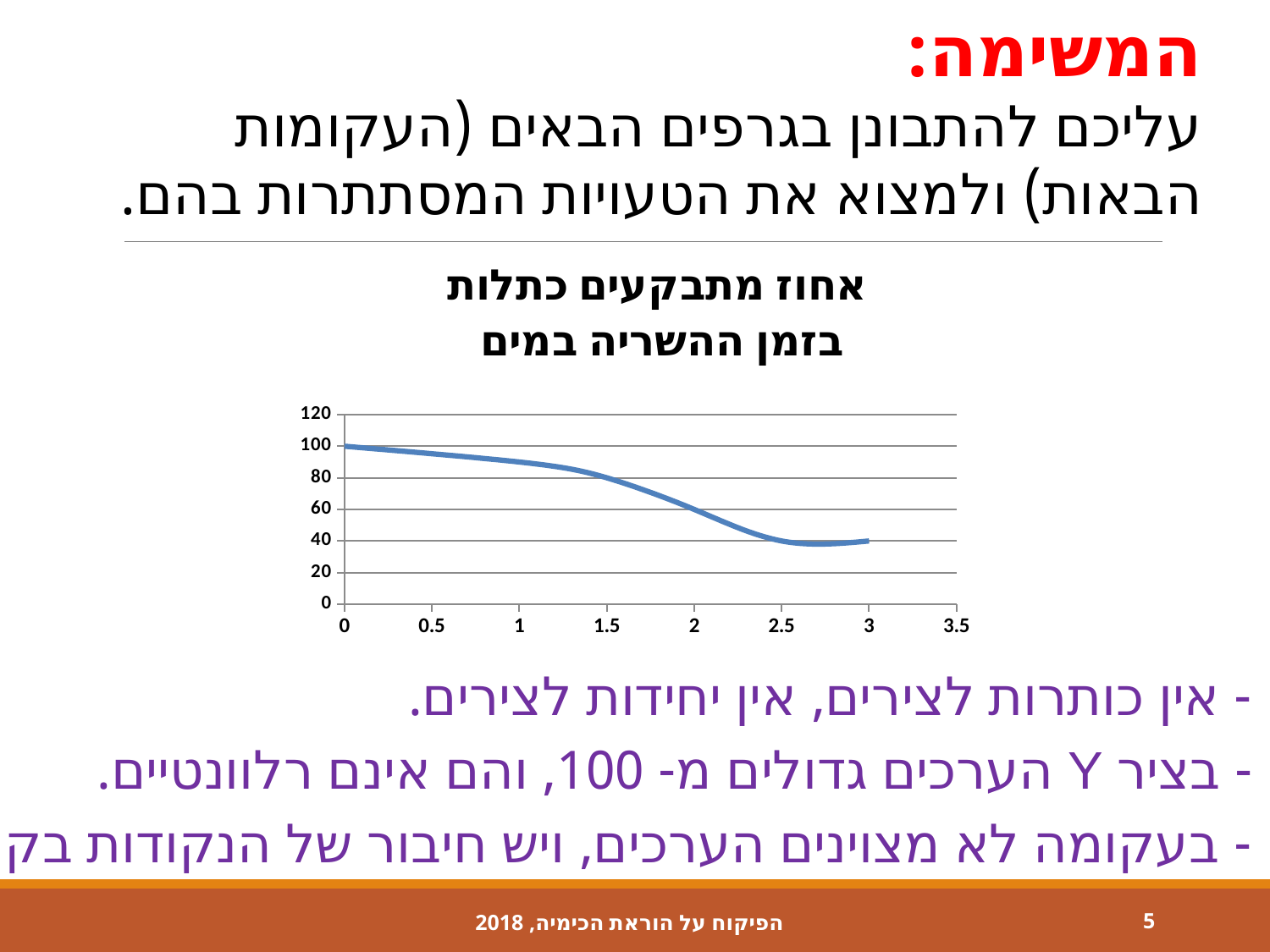
Is the value of the line at x = 3 greater or less than 60? less What kind of chart is shown on the slide? line chart What is the title of the chart? אחוז מתבקעים כתלות בזמן ההשריה במים Is the value of the line at x = 2.5 greater or less than 60? less Is the value of the line at x = 1 greater or less than 80? greater Does the plotted line rise or fall as the x value increases from 0 to 3? fall Which has the higher value on the line, x = 1 or x = 2.5? x = 1 What is the value of the line at x = 0? 100 What is the highest tick value shown on the y axis? 120